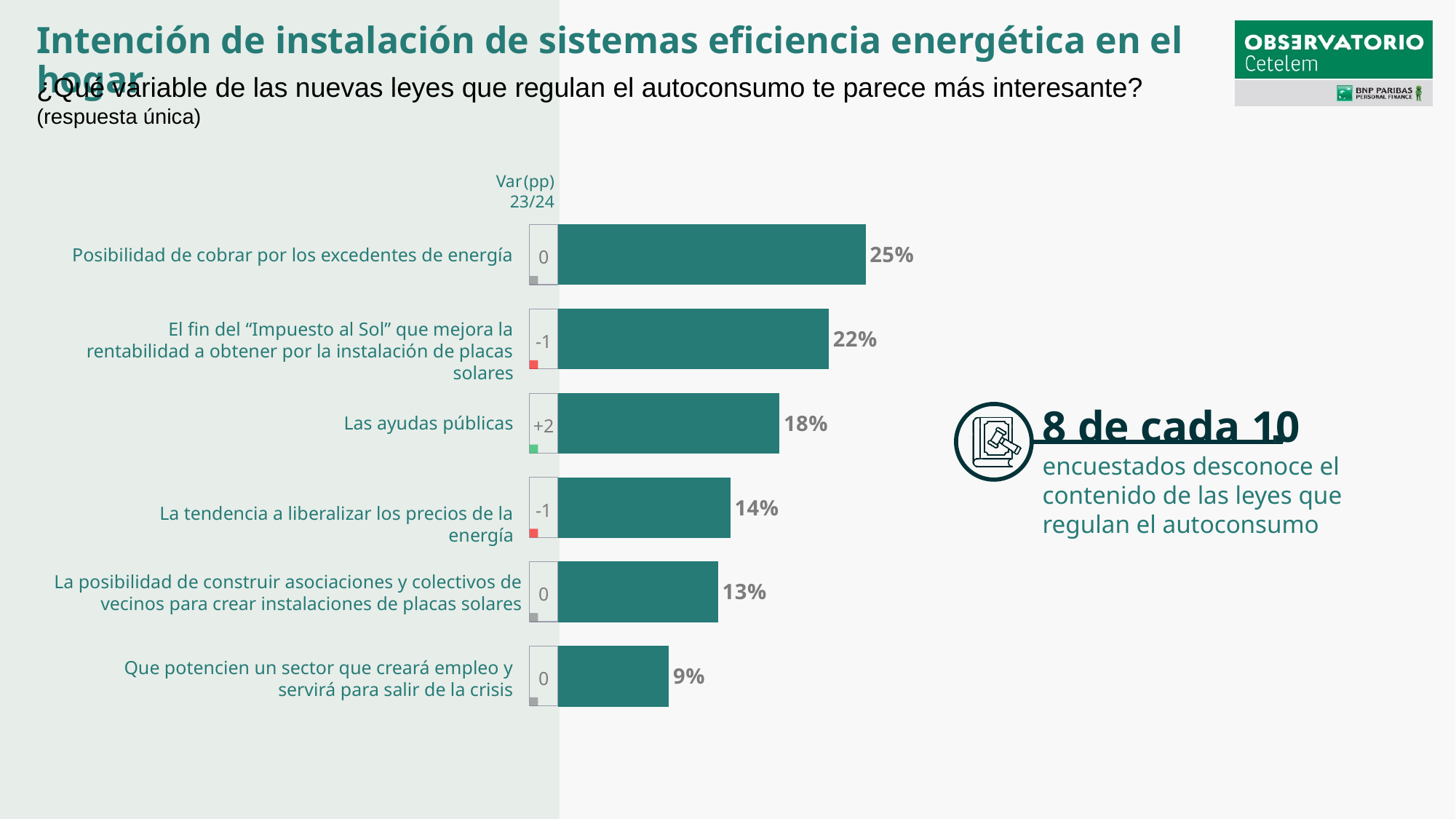
What is the difference between the values for 'Posibilidad de cobrar por los excedentes de energía' and 'El fin del “Impuesto al Sol”'? 3% What is the Var(pp) 23/24 value shown for 'El fin del “Impuesto al Sol”'? -1 Which is larger: the value for 'Las ayudas públicas' or for 'La tendencia a liberalizar los precios de la energía'? Las ayudas públicas What is the value for 'Que potencien un sector que creará empleo y servirá para salir de la crisis'? 9% What is the value for 'Las ayudas públicas'? 18% How many categories are shown in the chart? 6 What percentage of respondents chose 'Posibilidad de cobrar por los excedentes de energía'? 25% What is the Var(pp) 23/24 value shown for 'Las ayudas públicas'? +2 Which category has the highest value? Posibilidad de cobrar por los excedentes de energía What is the difference between the values for 'La posibilidad de construir asociaciones y colectivos de vecinos' and 'Que potencien un sector que creará empleo'? 4% Which category has the lowest value? Que potencien un sector que creará empleo y servirá para salir de la crisis What kind of chart is shown on the slide? Bar chart